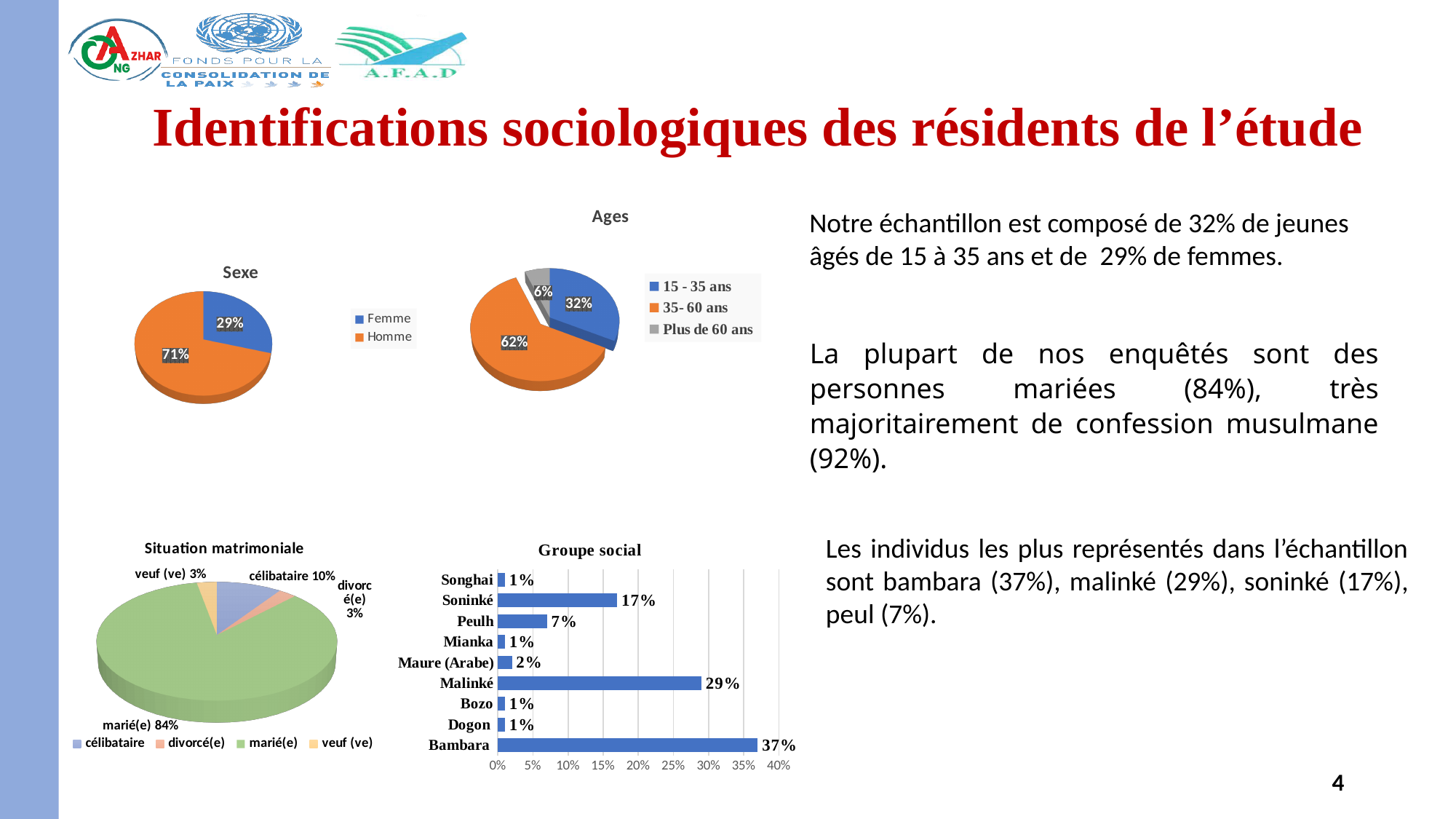
In the 'Groupe social' chart, which group has the highest value? Bambara In the 'Ages' pie chart, how many age groups does the legend list? 3 In the 'Ages' pie chart, which age group has the smallest share? Plus de 60 ans In the 'Groupe social' chart, how many social groups are shown? 9 In the 'Ages' pie chart, what percentage is the '35- 60 ans' group? 62% What type of chart is the 'Groupe social' chart? Bar chart In the 'Situation matrimoniale' pie chart, what is the difference between célibataire and veuf (ve)? 7% In the 'Situation matrimoniale' pie chart, what percentage is marié(e)? 84% In the 'Groupe social' chart, what is the difference between Bambara and Malinké? 8% In the 'Sexe' pie chart, what percentage is Homme? 71% In the 'Groupe social' chart, what is the value for Soninké? 17% In the 'Sexe' pie chart, what percentage is Femme? 29%